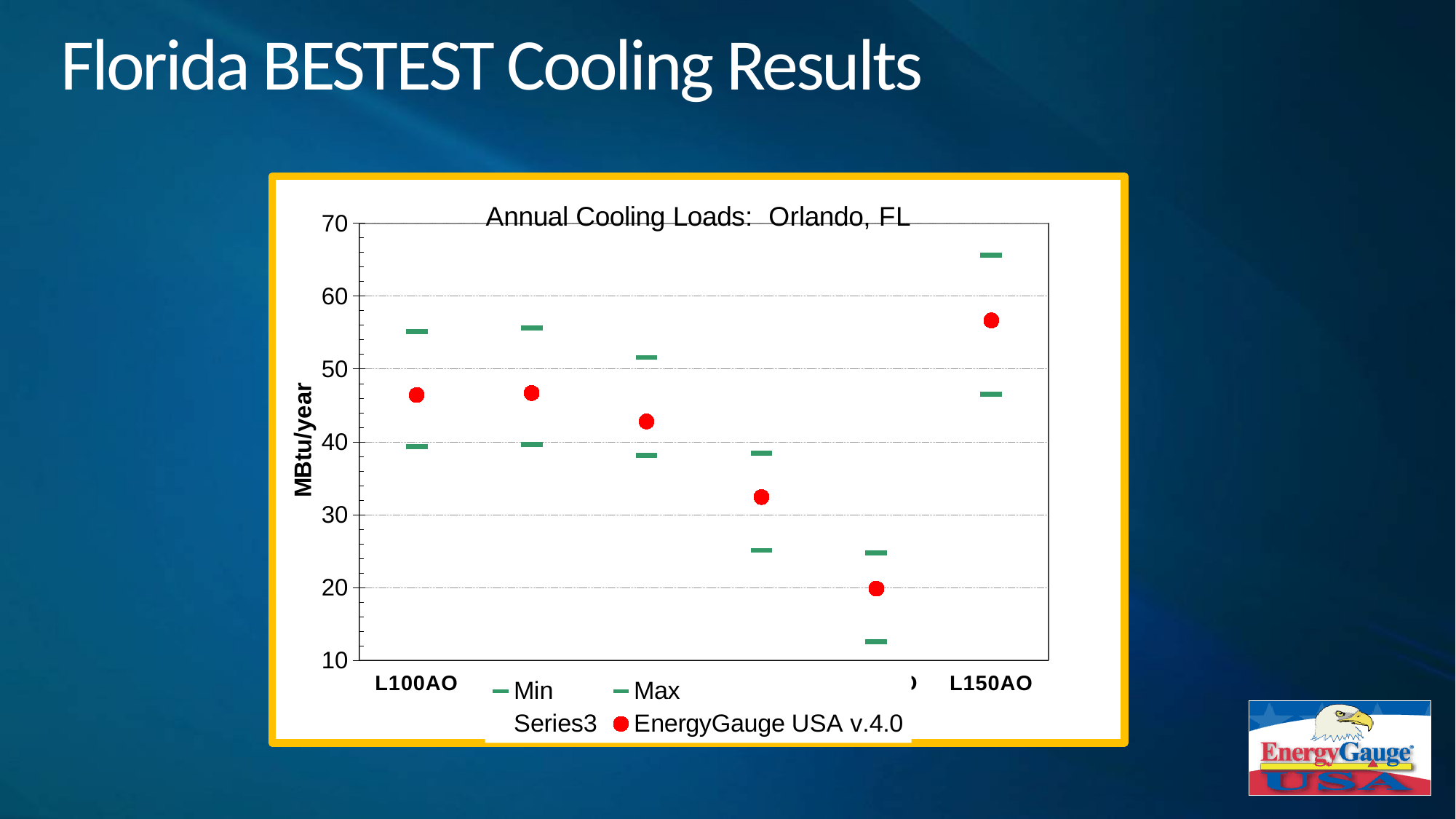
Is the EnergyGauge USA v.4.0 value for L100AO greater or less than 40? greater What is the label on the vertical axis of the chart? MBtu/year Is the Min value for L150AO greater or less than 40? greater Is the Max value for L150AO greater or less than 60? greater What is the title of the chart? Annual Cooling Loads: Orlando, FL Which has the larger Max value, L100AO or L150AO? L150AO Which has the larger EnergyGauge USA v.4.0 value, L100AO or L150AO? L150AO How many entries does the chart's legend list? 4 How many categories are plotted along the x axis of the chart? 6